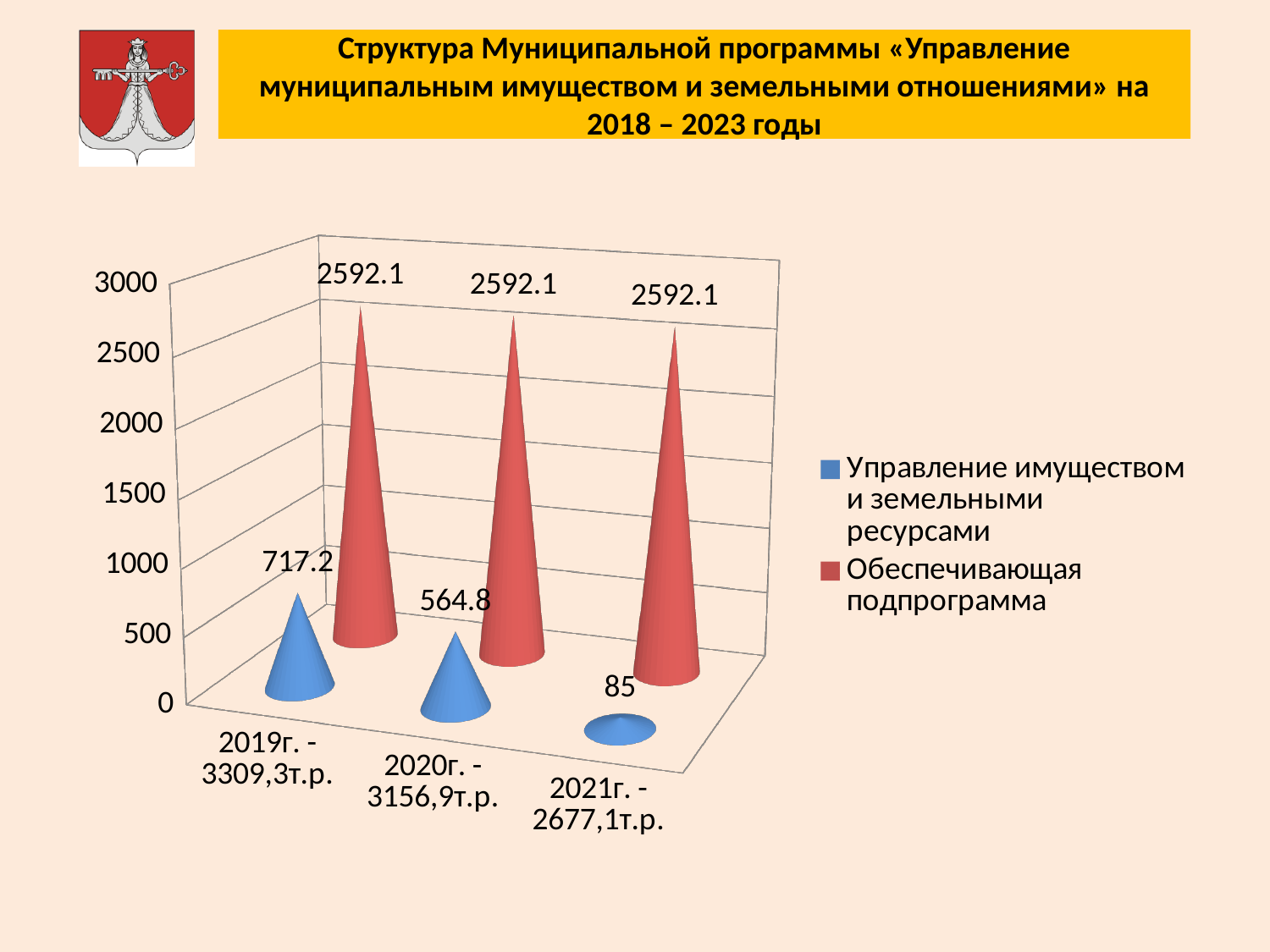
Do the values of «Управление имуществом и земельными ресурсами» rise or fall from 2019г. to 2021г.? fall In which year is the value of «Управление имуществом и земельными ресурсами» the highest? 2019г. What is the value of «Управление имуществом и земельными ресурсами» for 2019г.? 717.2 How many series does the legend list? 2 What is the value of «Обеспечивающая подпрограмма» for 2020г.? 2592.1 How many year categories are shown on the x axis? 3 What is the difference between the 2019г. and 2020г. values of «Управление имуществом и земельными ресурсами»? 152.4 What colour represents «Обеспечивающая подпрограмма» in the chart? red What is the value of «Управление имуществом и земельными ресурсами» for 2021г.? 85 Which series has the larger value in 2021г., «Управление имуществом и земельными ресурсами» or «Обеспечивающая подпрограмма»? Обеспечивающая подпрограмма What kind of chart is shown on the slide? bar chart In which year is the value of «Управление имуществом и земельными ресурсами» the lowest? 2021г.